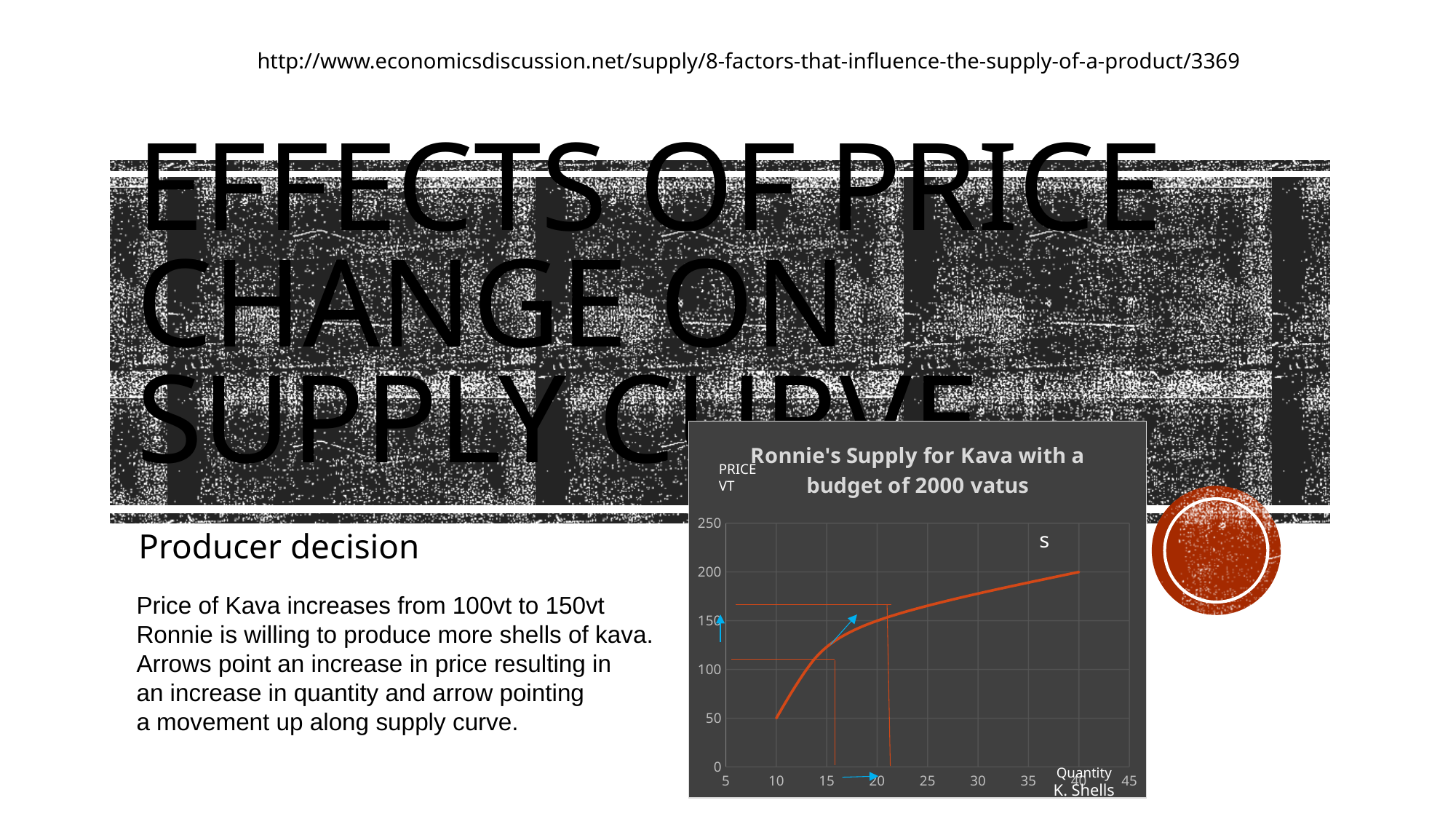
Is the price on the supply curve at a quantity of 10 greater or less than 100? less Is the price on the supply curve at a quantity of 40 greater or less than 150? greater Is the price on the supply curve at a quantity of 30 greater or less than 150? greater Does the supply curve rise or fall as quantity increases along the x axis? rise What label is given to the curve plotted on the chart? S What is the title of the chart? Ronnie's Supply for Kava with a budget of 2000 vatus Which is higher on the supply curve: the price at a quantity of 10 or the price at a quantity of 40? quantity of 40 What is the highest value shown on the vertical (price) axis? 250 How many tick values are labelled on the horizontal (quantity) axis? 9 What kind of chart is shown on the slide? line chart